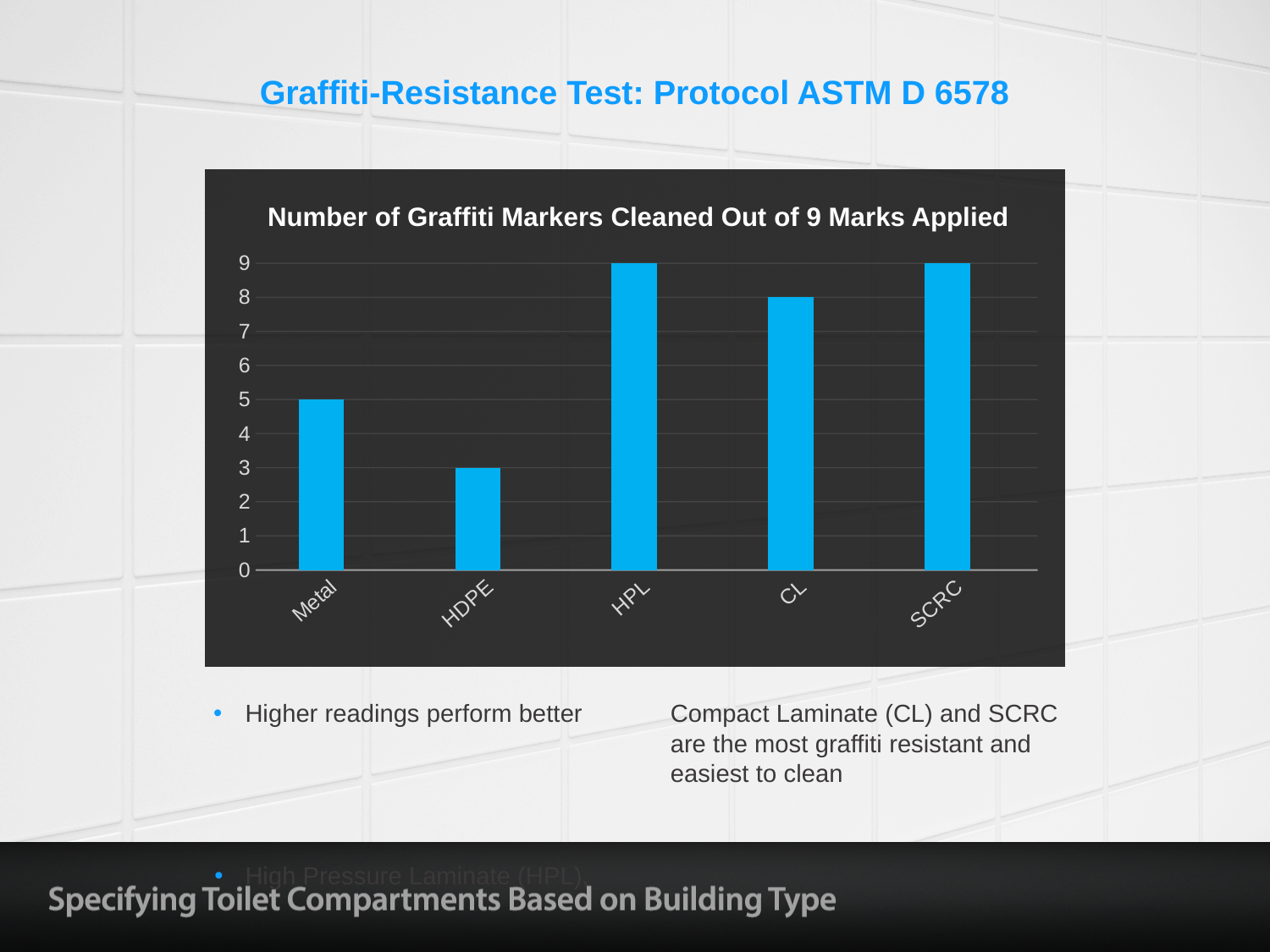
How many categories are plotted on the x axis? 5 Which two categories share the highest value? HPL and SCRC Which category has the lowest value? HDPE What is the title of the chart? Number of Graffiti Markers Cleaned Out of 9 Marks Applied What is the difference between the values for HPL and HDPE? 6 What is the value for HDPE? 3 Which is larger, the value for Metal or the value for CL? CL What is the value for SCRC? 9 What kind of chart is shown on the slide? Bar chart Is the value for Metal greater or less than 4? greater What is the value for Metal? 5 What is the value for CL? 8